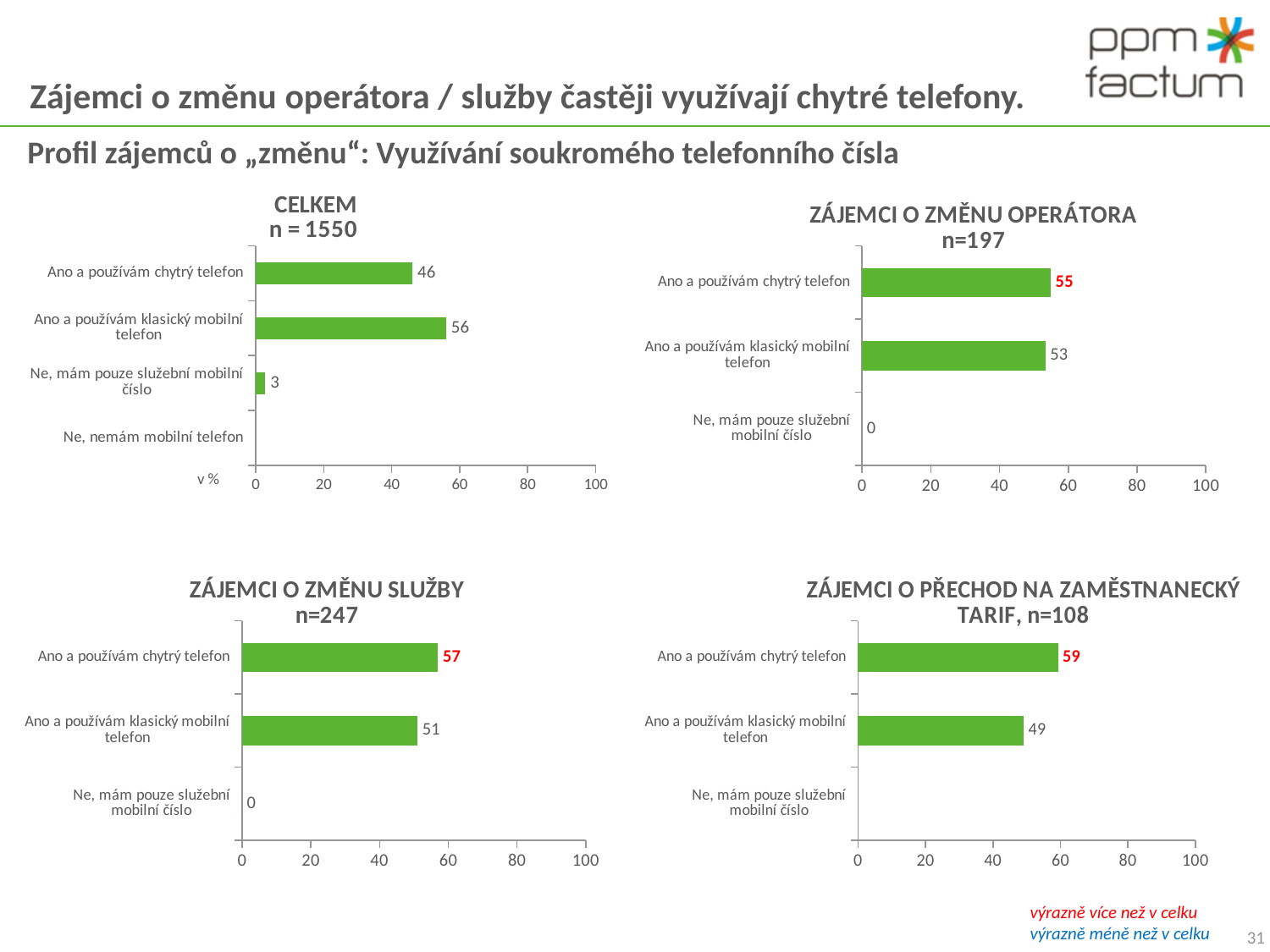
In the CELKEM chart, which category has the highest value? Ano a používám klasický mobilní telefon In the ZÁJEMCI O ZMĚNU SLUŽBY chart, what is the value for "Ano a používám klasický mobilní telefon"? 51 In the ZÁJEMCI O ZMĚNU SLUŽBY chart, what is the difference between "Ano a používám chytrý telefon" and "Ano a používám klasický mobilní telefon"? 6 In the CELKEM chart, what is the difference between "Ano a používám klasický mobilní telefon" and "Ano a používám chytrý telefon"? 10 What type of chart is the ZÁJEMCI O ZMĚNU SLUŽBY chart? Bar chart In the ZÁJEMCI O PŘECHOD NA ZAMĚSTNANECKÝ TARIF chart, which is larger: "Ano a používám chytrý telefon" or "Ano a používám klasický mobilní telefon"? Ano a používám chytrý telefon In the CELKEM chart, what is the value for "Ano a používám klasický mobilní telefon"? 56 In the ZÁJEMCI O ZMĚNU OPERÁTORA chart, what is the value for "Ano a používám chytrý telefon"? 55 In the ZÁJEMCI O ZMĚNU OPERÁTORA chart, what is the value for "Ne, mám pouze služební mobilní číslo"? 0 In the ZÁJEMCI O PŘECHOD NA ZAMĚSTNANECKÝ TARIF chart, what is the value for "Ano a používám chytrý telefon"? 59 How many categories are shown in the CELKEM chart? 4 In the CELKEM chart, what is the value for "Ne, mám pouze služební mobilní číslo"? 3